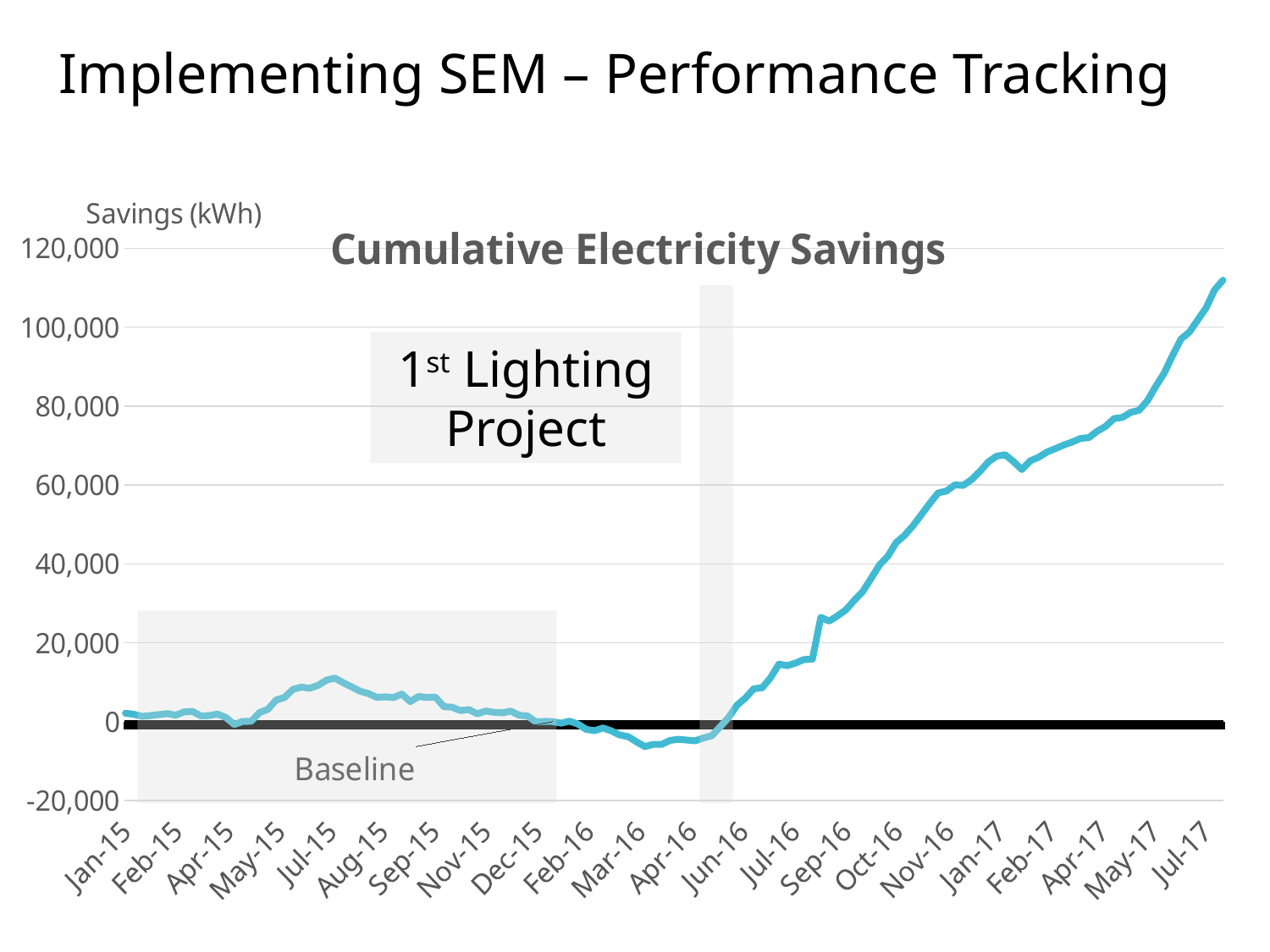
Is the cumulative savings value at Jul-17 greater or less than 100,000? greater Does the cumulative savings line rise or fall between Jun-16 and Jul-17? rise What is the title of the chart? Cumulative Electricity Savings Is the cumulative savings value at Mar-16 greater or less than 0? less Is the cumulative savings value at Jan-17 greater or less than 60,000? greater Which is larger, the cumulative savings at Jul-16 or at Nov-16? Nov-16 At which x-axis label does the cumulative savings line reach its highest value? Jul-17 What kind of chart is shown on the slide? line chart What unit is shown on the vertical axis label of the chart? Savings (kWh)